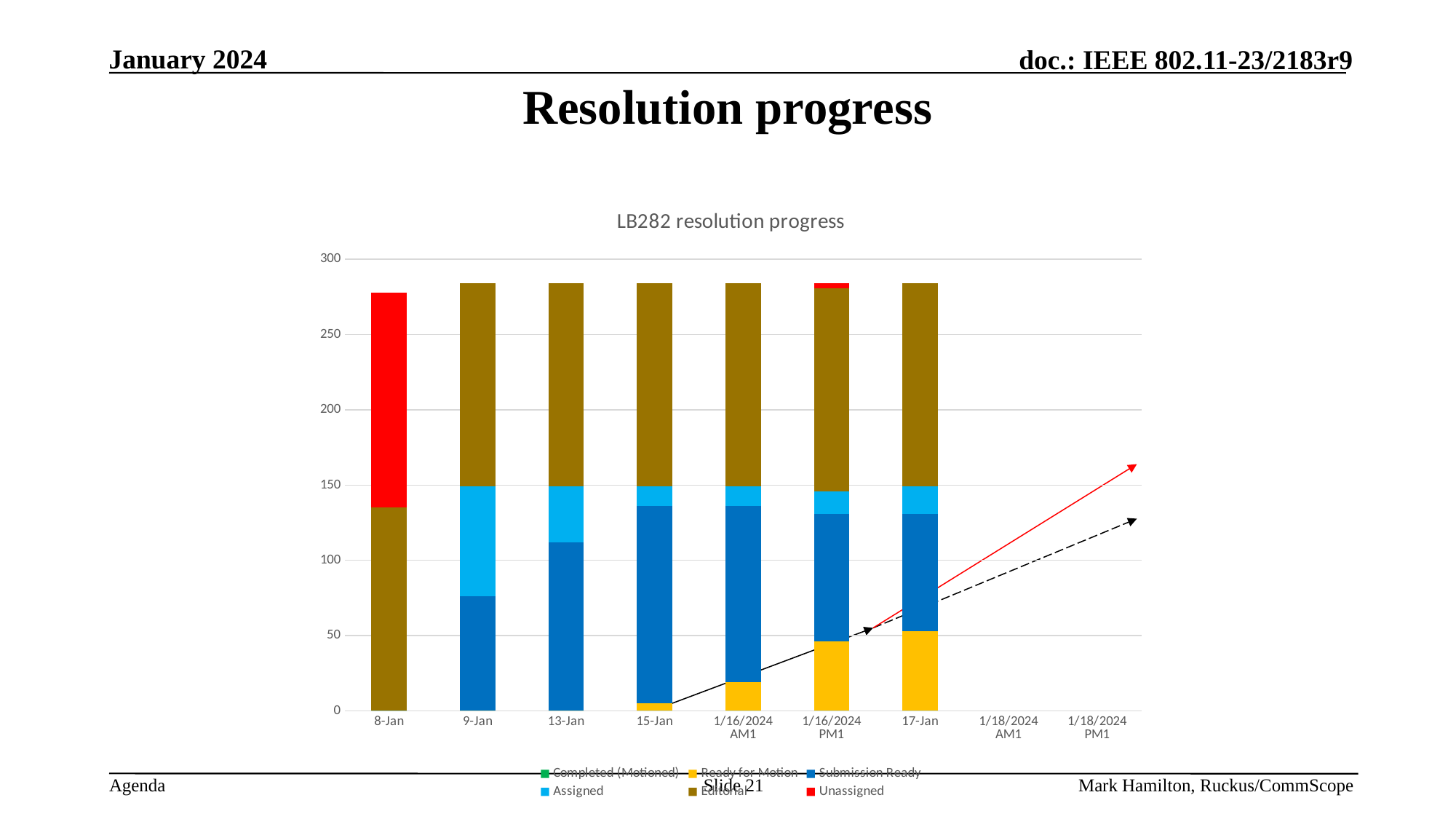
Is the Unassigned value on 8-Jan greater or less than 100? greater Is the Assigned value larger on 9-Jan or on 13-Jan? 9-Jan How many series does the chart legend list? 6 Is the Submission Ready value on 9-Jan greater or less than 50? greater What kind of chart is shown on the slide? Stacked bar chart Is the Ready for Motion value on 1/16/2024 AM1 greater or less than 50? less How many category labels are shown on the x axis? 9 How many dates on the x axis have a bar plotted? 7 Does the Ready for Motion value rise or fall from 15-Jan to 17-Jan? rise Which date has the largest Unassigned segment? 8-Jan What is the title of the chart? LB282 resolution progress